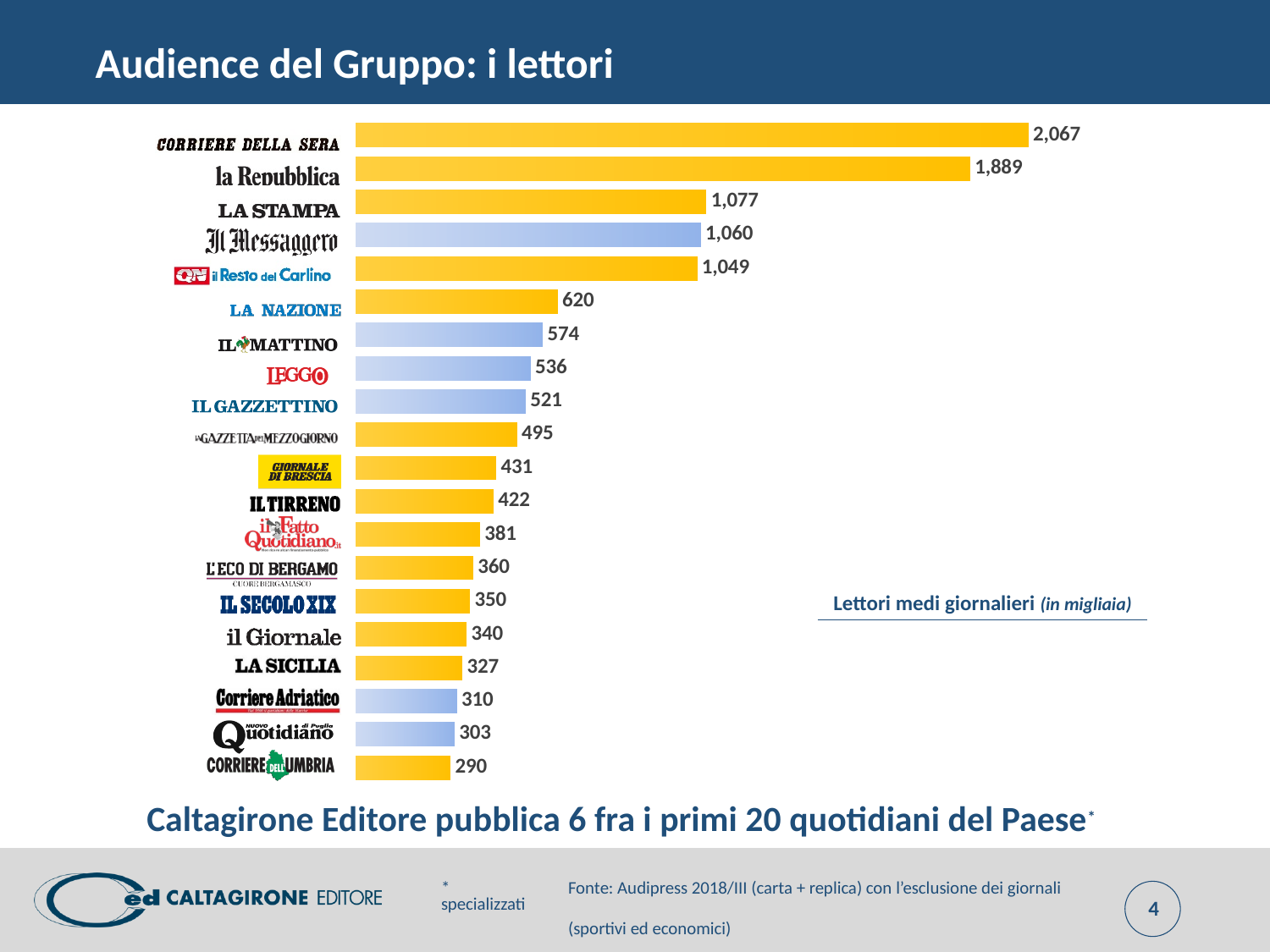
What is the difference between the values for Il Messaggero and Leggo? 524 What is the difference between the values for Corriere della Sera and la Repubblica? 178 Which newspaper has the highest number of average daily readers? Corriere della Sera What is the value shown for Il Gazzettino? 521 What is the value shown for Corriere Adriatico? 310 What kind of chart is shown on the slide? Bar chart Which newspaper has the lowest number of average daily readers? Corriere dell'Umbria What unit are the readers expressed in, according to the chart label? In migliaia (thousands) How many newspapers are shown in the chart? 20 Which has a larger value, La Nazione or Il Mattino? La Nazione What is the value shown for Corriere della Sera? 2,067 What is the value shown for Il Messaggero? 1,060